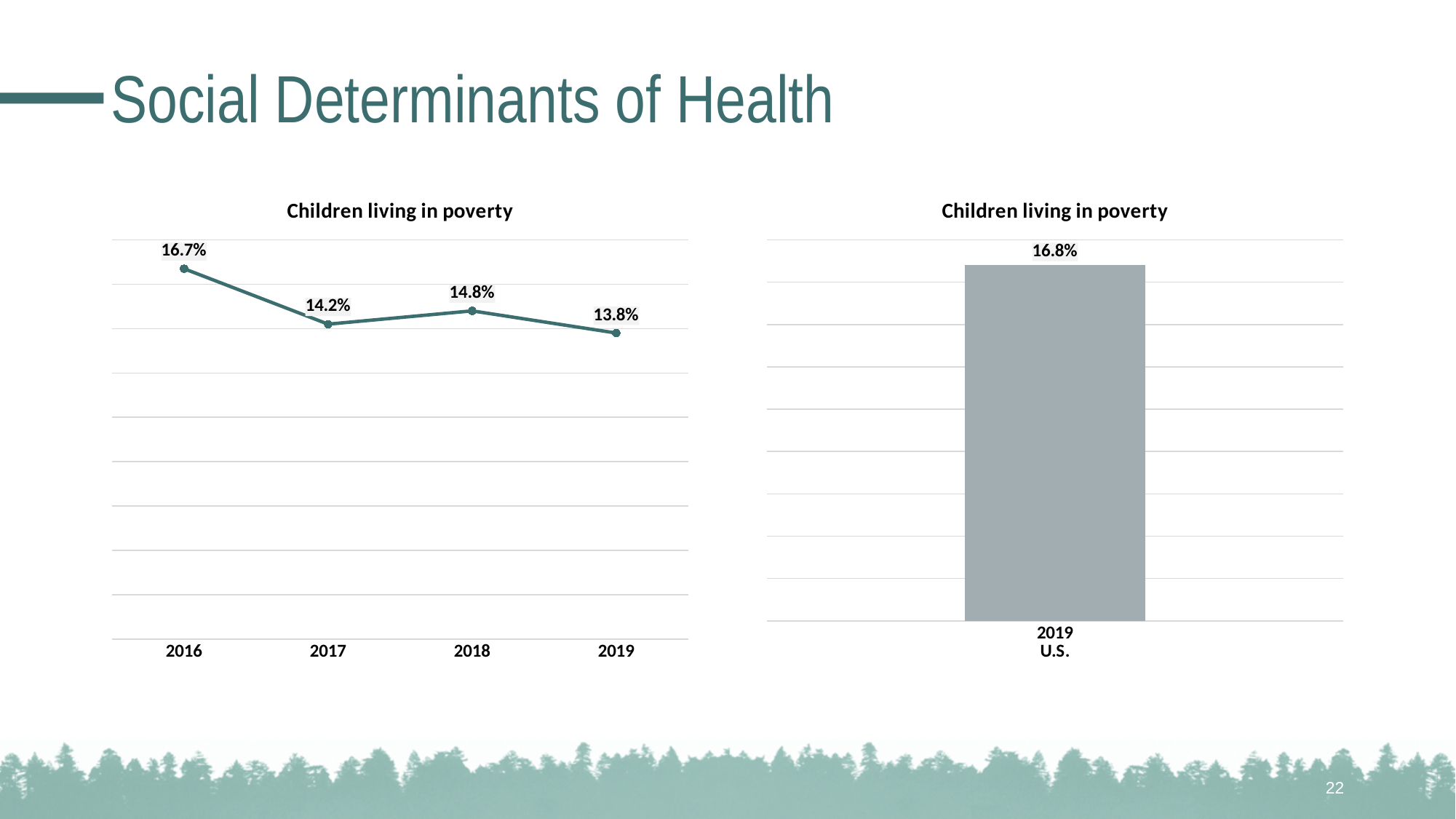
In the left chart, what is the value for 2016? 16.7% In the left chart, what is the difference between the 2016 and 2019 values? 2.9% In the left chart, what is the value for 2019? 13.8% In the left chart, which year has the lowest value? 2019 In the right chart, what is the value for 2019 U.S.? 16.8% In the left chart, what is the value for 2018? 14.8% In the left chart, which year has the highest value? 2016 In the left chart, which is larger, the value for 2017 or the value for 2018? 2018 How many years are plotted in the left chart? 4 What kind of chart is the right chart? bar chart What kind of chart is the left chart? line chart In the left chart, do the values generally rise or fall from 2016 to 2019? fall